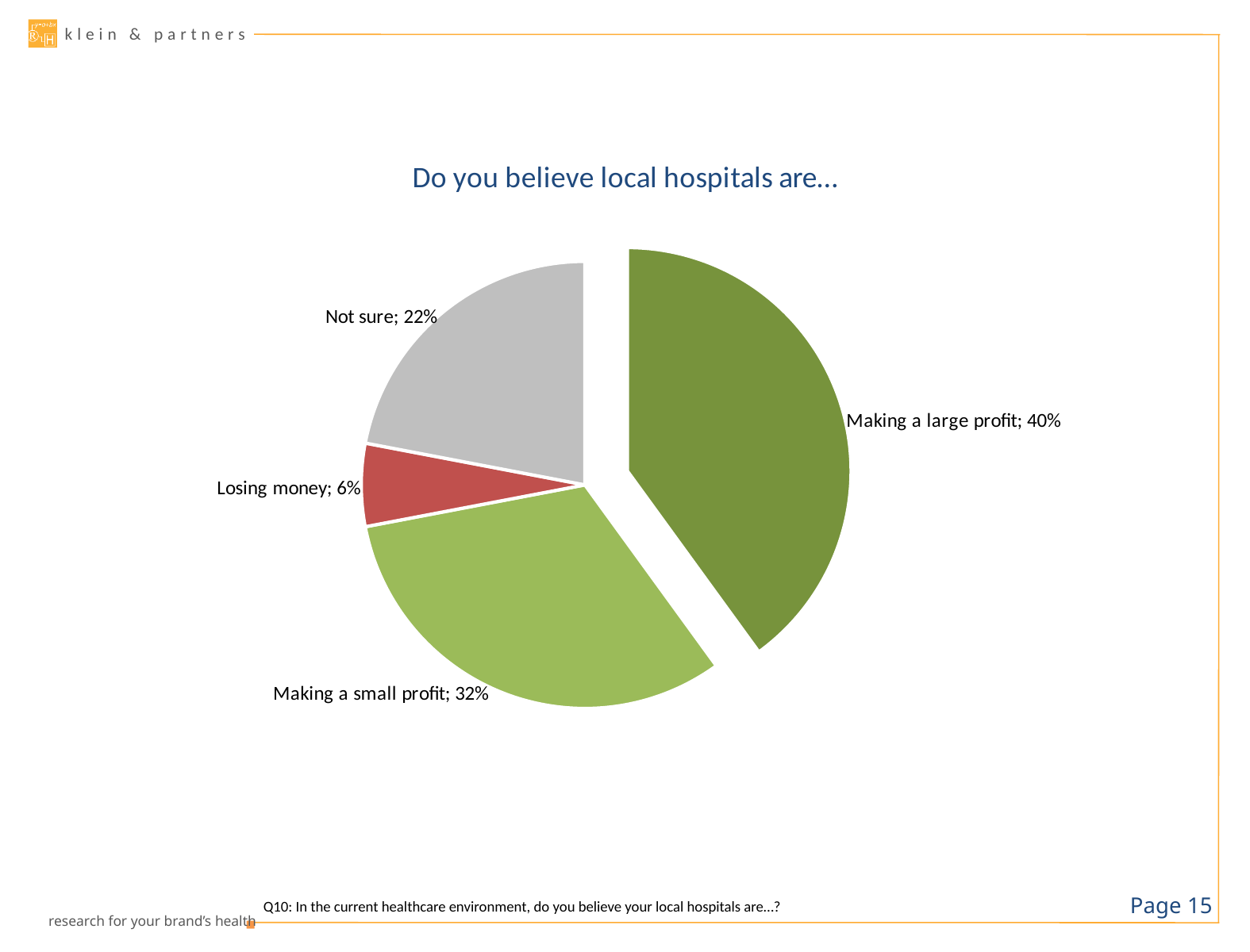
What percentage of respondents answered 'Not sure'? 22% What is the title of the chart? Do you believe local hospitals are… Which is larger, the share for 'Not sure' or the share for 'Losing money'? Not sure What is the difference in percentage points between 'Making a large profit' and 'Making a small profit'? 8 What kind of chart is shown on the slide? pie chart How many slices does the pie chart have? 4 Which slice is pulled out (exploded) from the rest of the pie? Making a large profit What percentage of respondents believe local hospitals are making a small profit? 32% Which response has the smallest share of the pie? Losing money What percentage of respondents believe local hospitals are making a large profit? 40% Which response has the largest share of the pie? Making a large profit What percentage of respondents believe local hospitals are losing money? 6%